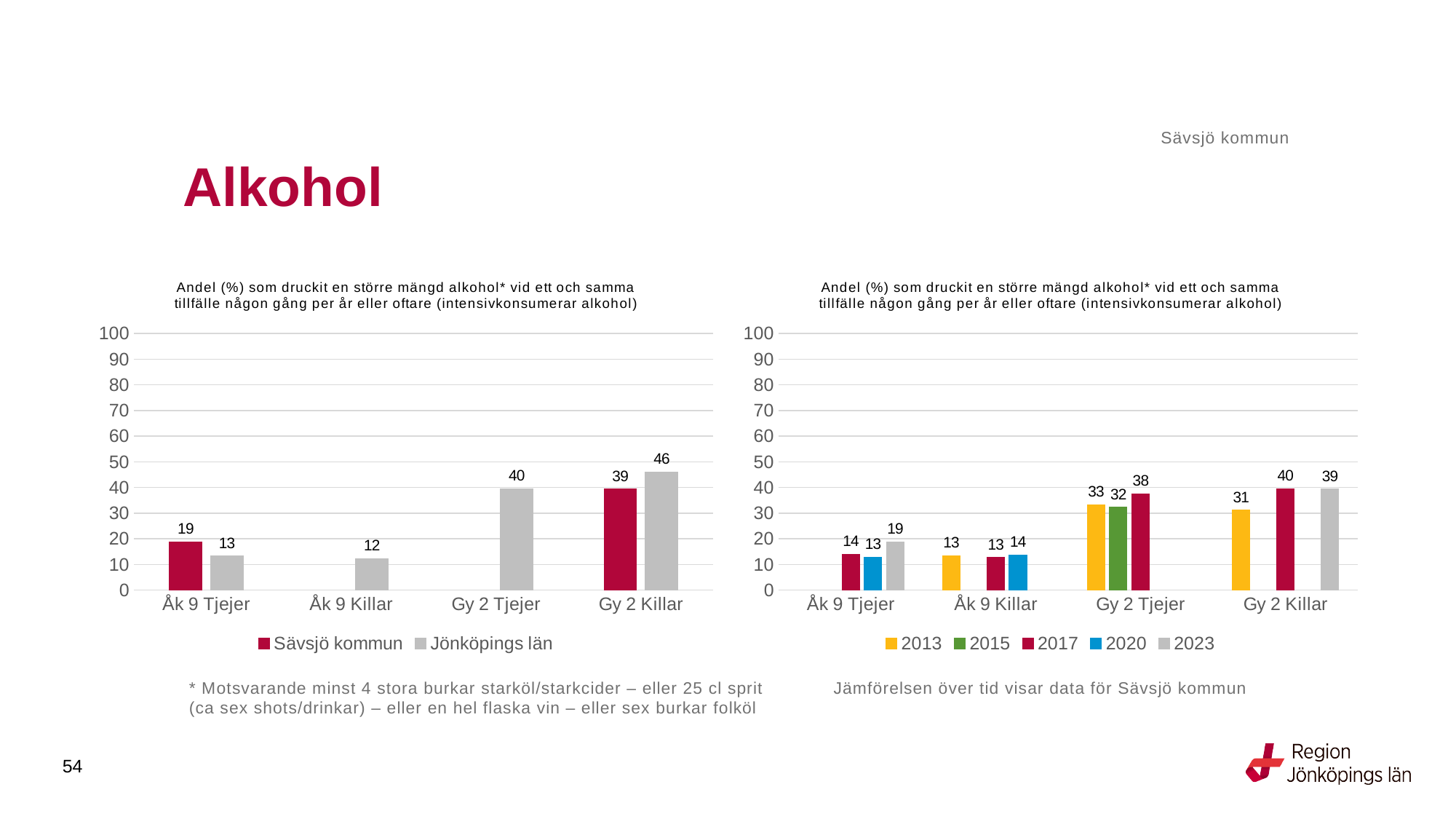
How many series does the legend of the left chart list? 2 In the left chart, what is the value for Jönköpings län for Gy 2 Killar? 46 In the left chart, what is the value for Sävsjö kommun for Åk 9 Tjejer? 19 How many series does the legend of the right chart list? 5 In the right chart, what is the value for 2023 for Åk 9 Tjejer? 19 In the left chart, which is larger for Åk 9 Tjejer: Sävsjö kommun or Jönköpings län? Sävsjö kommun In the right chart, what is the difference between the 2017 and 2013 values for Gy 2 Killar? 9 In the right chart, what is the value for 2017 for Gy 2 Tjejer? 38 In the left chart, what is the difference between Jönköpings län and Sävsjö kommun for Gy 2 Killar? 7 In the right chart, which year has the lowest value for Gy 2 Killar? 2013 In the left chart, which category has the highest value for Jönköpings län? Gy 2 Killar What type of chart is the right chart? Bar chart